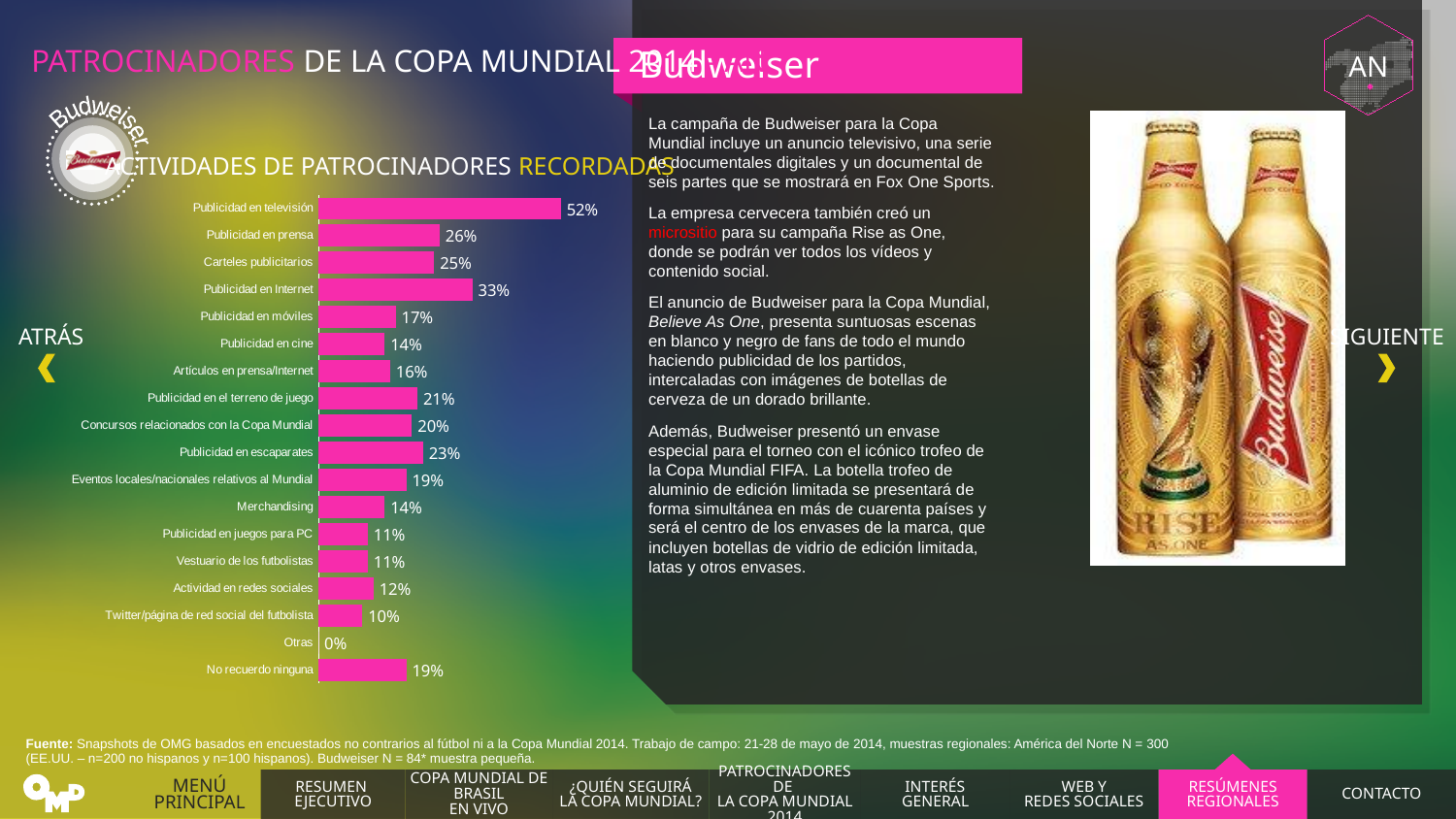
What is the difference between Publicidad en prensa and Carteles publicitarios? 1% What is the difference between Publicidad en televisión and Publicidad en Internet? 19% How many categories are shown in the bar chart? 18 Which category has the highest value? Publicidad en televisión What value is shown for Publicidad en televisión? 52% What value is shown for Publicidad en Internet? 33% What type of chart is used on the slide? Bar chart What value is shown for No recuerdo ninguna? 19% What value is shown for Actividad en redes sociales? 12% Which is larger, Publicidad en escaparates or Publicidad en el terreno de juego? Publicidad en escaparates What is the title of the chart? ACTIVIDADES DE PATROCINADORES RECORDADAS Which category has the lowest value? Otras